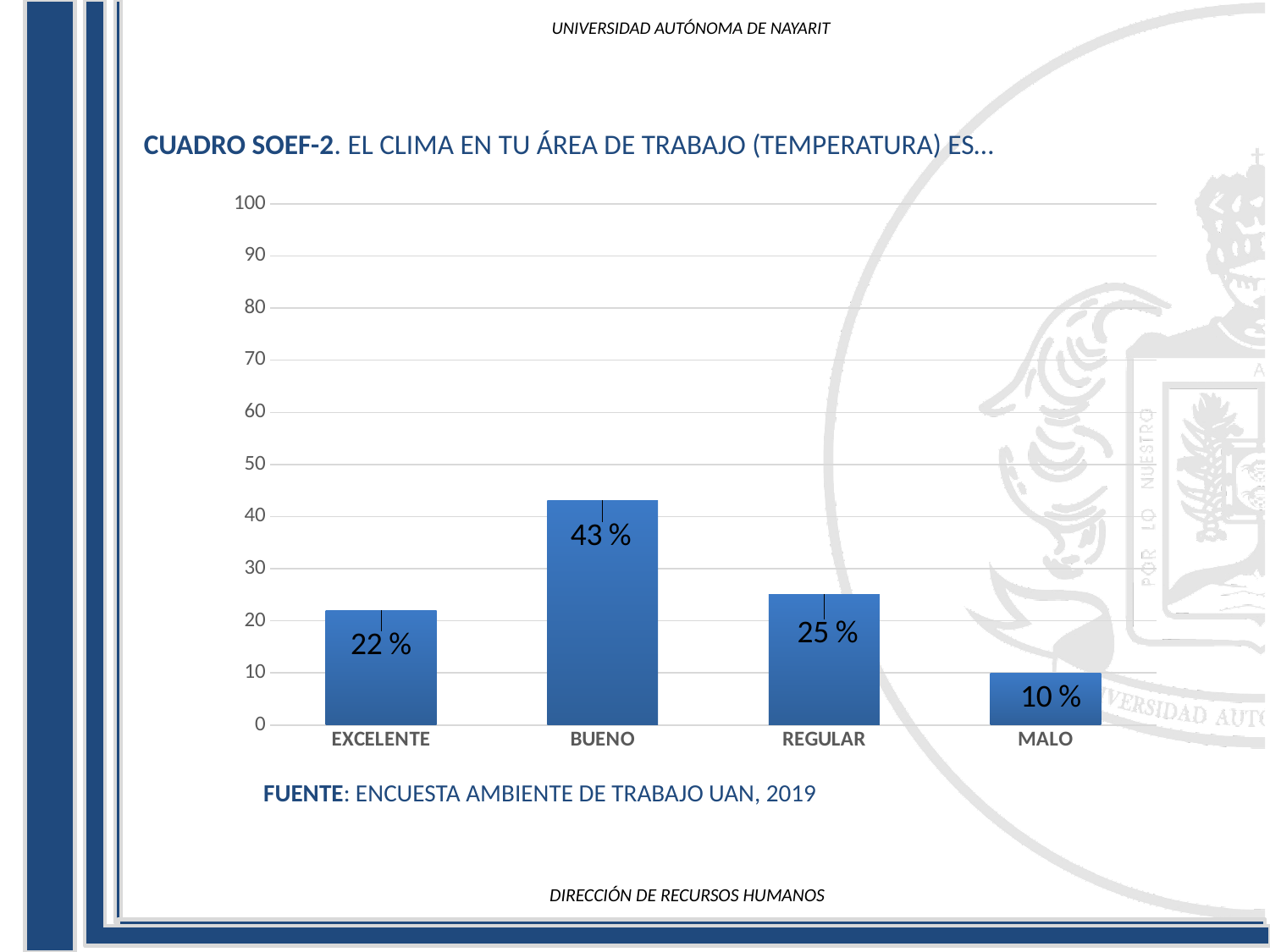
What is the value for BUENO? 43 % Which category has the lowest value? MALO What is the title of the chart? CUADRO SOEF-2. EL CLIMA EN TU ÁREA DE TRABAJO (TEMPERATURA) ES… What is the difference between the values for BUENO and REGULAR? 18 % What is the value for MALO? 10 % What is the source cited below the chart? ENCUESTA AMBIENTE DE TRABAJO UAN, 2019 Is the value for BUENO greater or less than 50? less Which category has the highest value? BUENO Which is larger, the value for REGULAR or the value for EXCELENTE? REGULAR What is the value for EXCELENTE? 22 % What kind of chart is shown on the slide? bar chart How many categories are shown on the x axis? 4